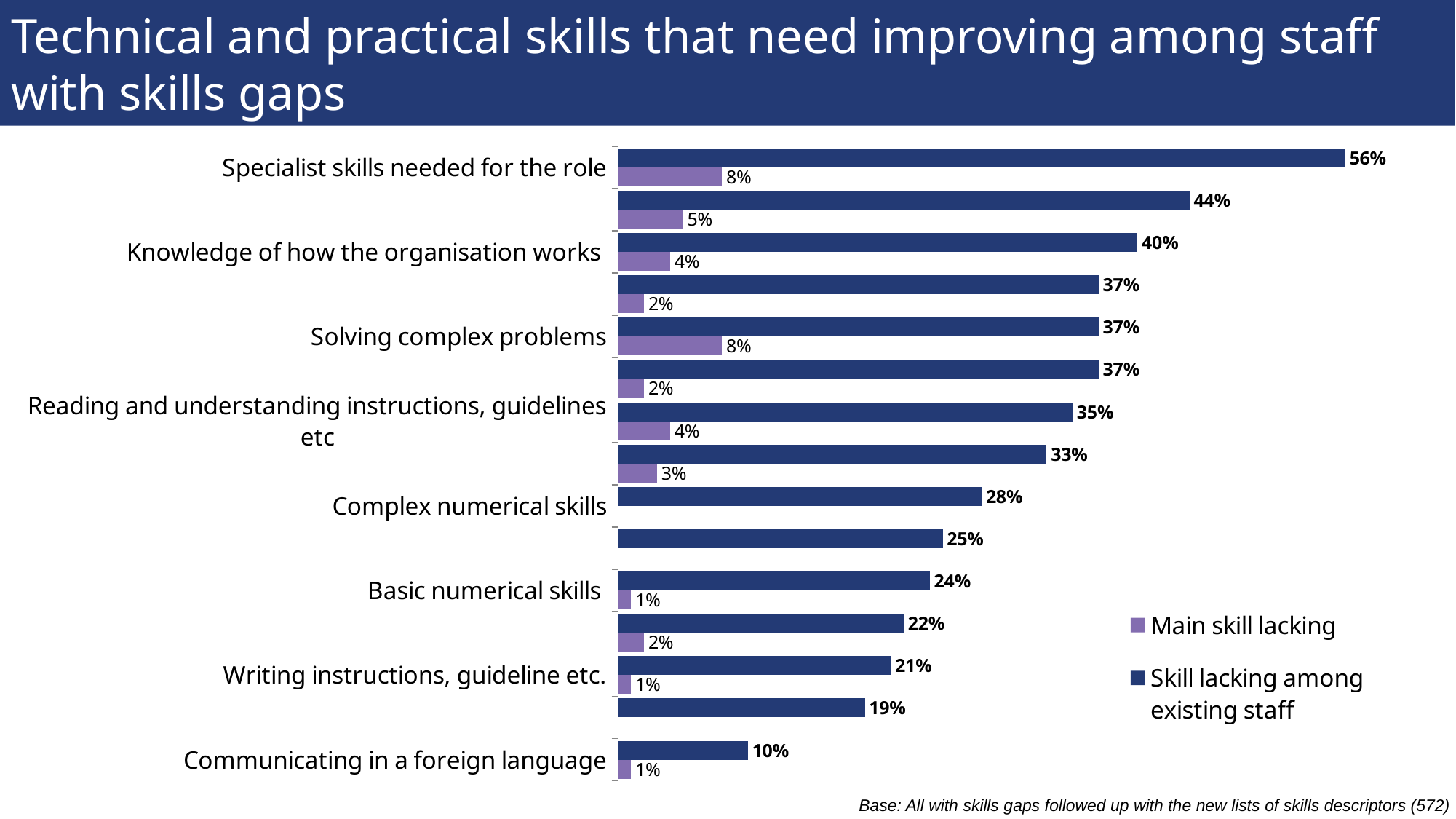
What is the value of 'Skill lacking among existing staff' for Communicating in a foreign language? 10% What is the value of 'Main skill lacking' for Solving complex problems? 8% Which labelled category has the highest 'Skill lacking among existing staff' value? Specialist skills needed for the role What is the value of 'Skill lacking among existing staff' for Specialist skills needed for the role? 56% What is the value of 'Skill lacking among existing staff' for Knowledge of how the organisation works? 40% Which labelled category has the lowest 'Skill lacking among existing staff' value? Communicating in a foreign language What is the difference between the 'Skill lacking among existing staff' values for Specialist skills needed for the role and Knowledge of how the organisation works? 16% Which has a larger 'Skill lacking among existing staff' value: Basic numerical skills or Writing instructions, guideline etc.? Basic numerical skills How many series does the legend list? 2 What type of chart is shown on the slide? Bar chart What is the value of 'Main skill lacking' for Specialist skills needed for the role? 8% What is the value of 'Skill lacking among existing staff' for Complex numerical skills? 28%